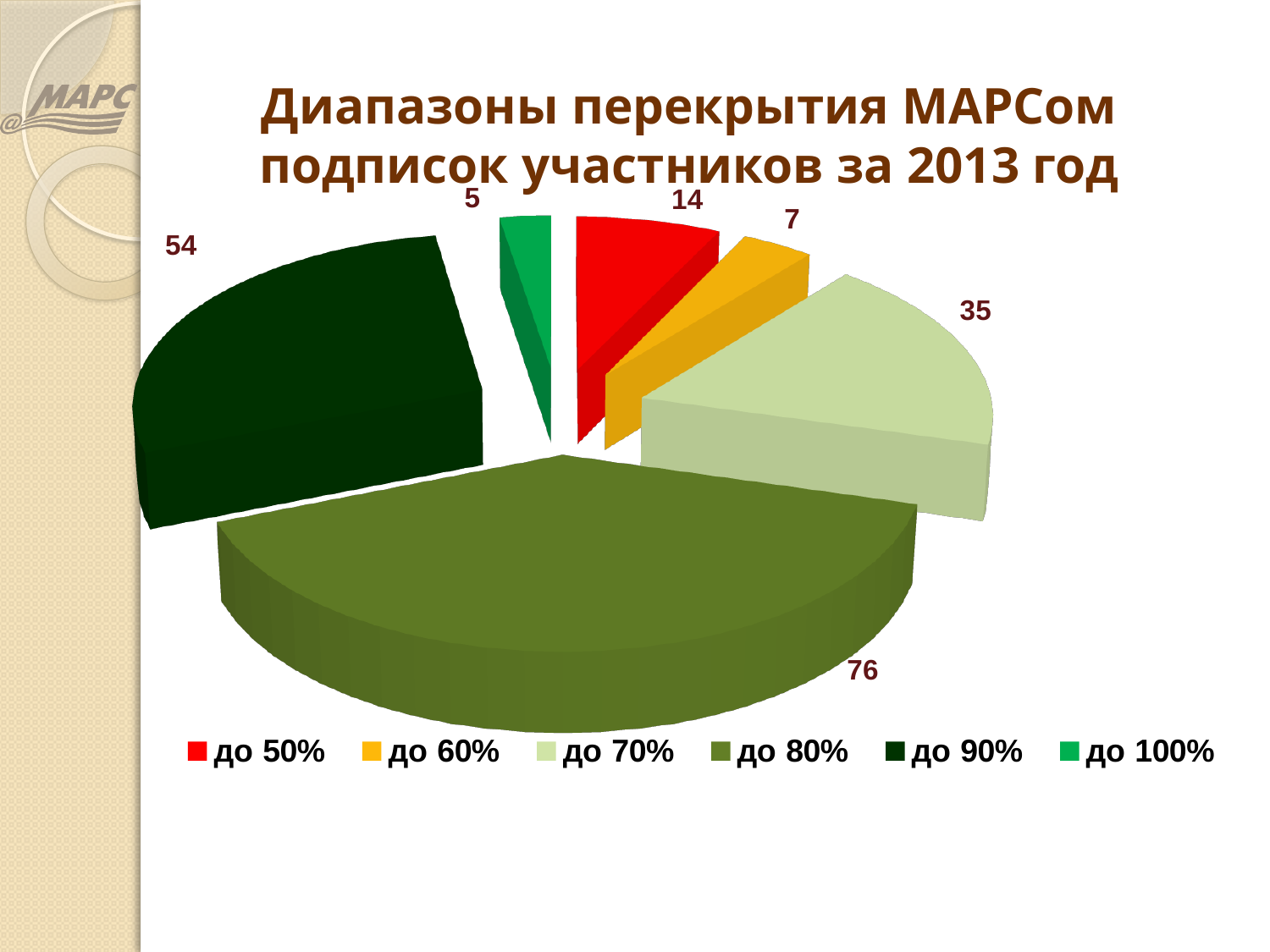
What is the value for the 'до 80%' slice? 76 How many categories does the pie chart have? 6 What colour is the 'до 60%' slice? Orange What is the value for the 'до 70%' slice? 35 Which category has the largest slice? до 80% Which is larger, the value for 'до 60%' or the value for 'до 50%'? до 50% What is the value for the 'до 100%' slice? 5 Which category has the smallest slice? до 100% What is the value for the 'до 50%' slice? 14 What kind of chart is shown on the slide? Pie chart What is the difference between the values for 'до 80%' and 'до 90%'? 22 What is the total of all slice values in the pie chart? 191